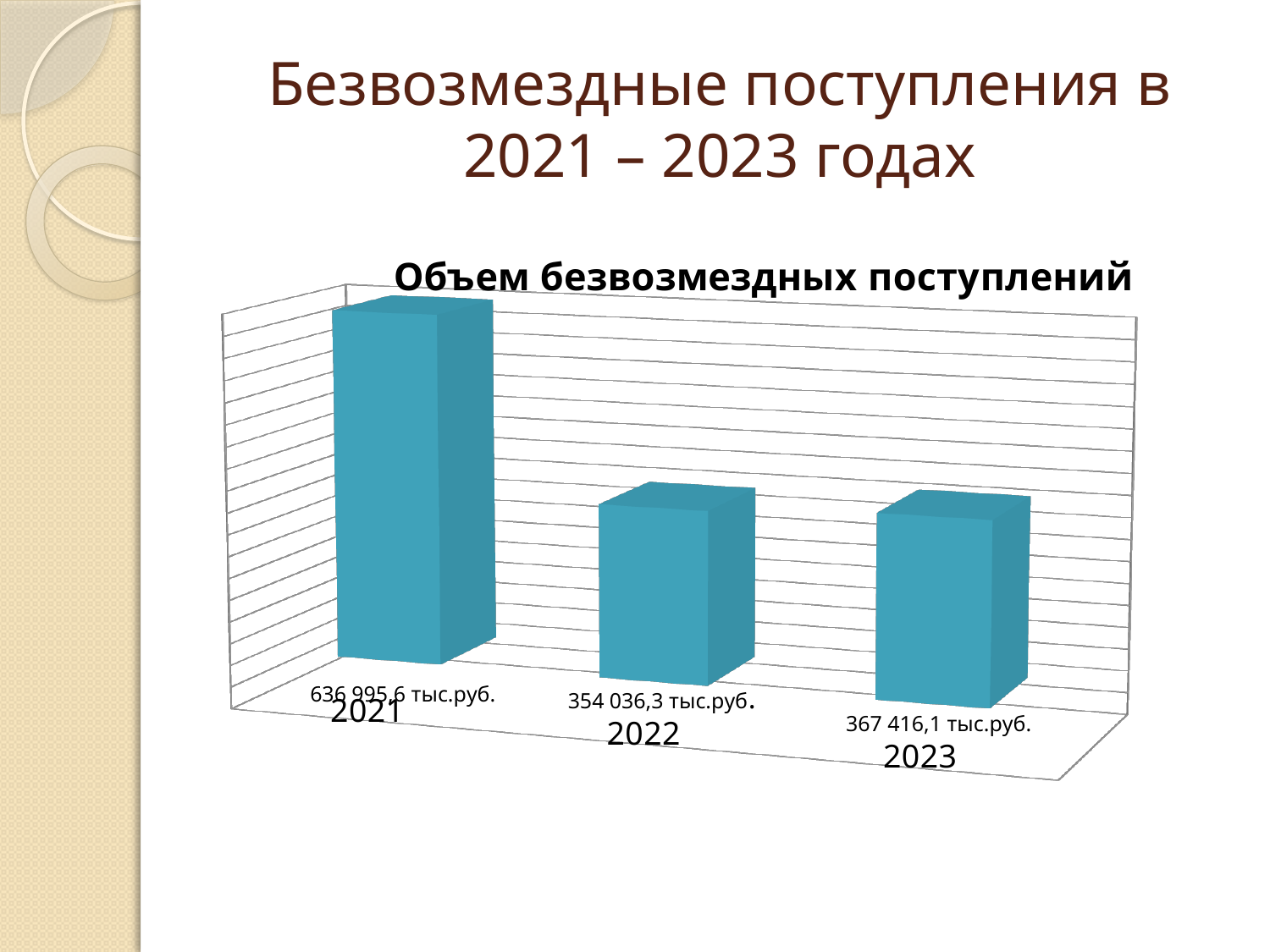
How many years are shown in the chart? 3 What kind of chart is shown on the slide? Bar chart Which year has the highest volume of gratuitous receipts? 2021 What is the value for 2021 in the chart? 636 995,6 тыс.руб. Which year has the lowest volume of gratuitous receipts? 2022 What is the difference between the values for 2023 and 2022? 13 379,8 тыс.руб. What is the title of the chart? Объем безвозмездных поступлений What is the value for 2022 in the chart? 354 036,3 тыс.руб. What is the value for 2023 in the chart? 367 416,1 тыс.руб. Which is larger, the value for 2022 or the value for 2023? 2023 What is the difference between the values for 2021 and 2022? 282 959,3 тыс.руб. Does the value rise or fall from 2021 to 2022? Fall